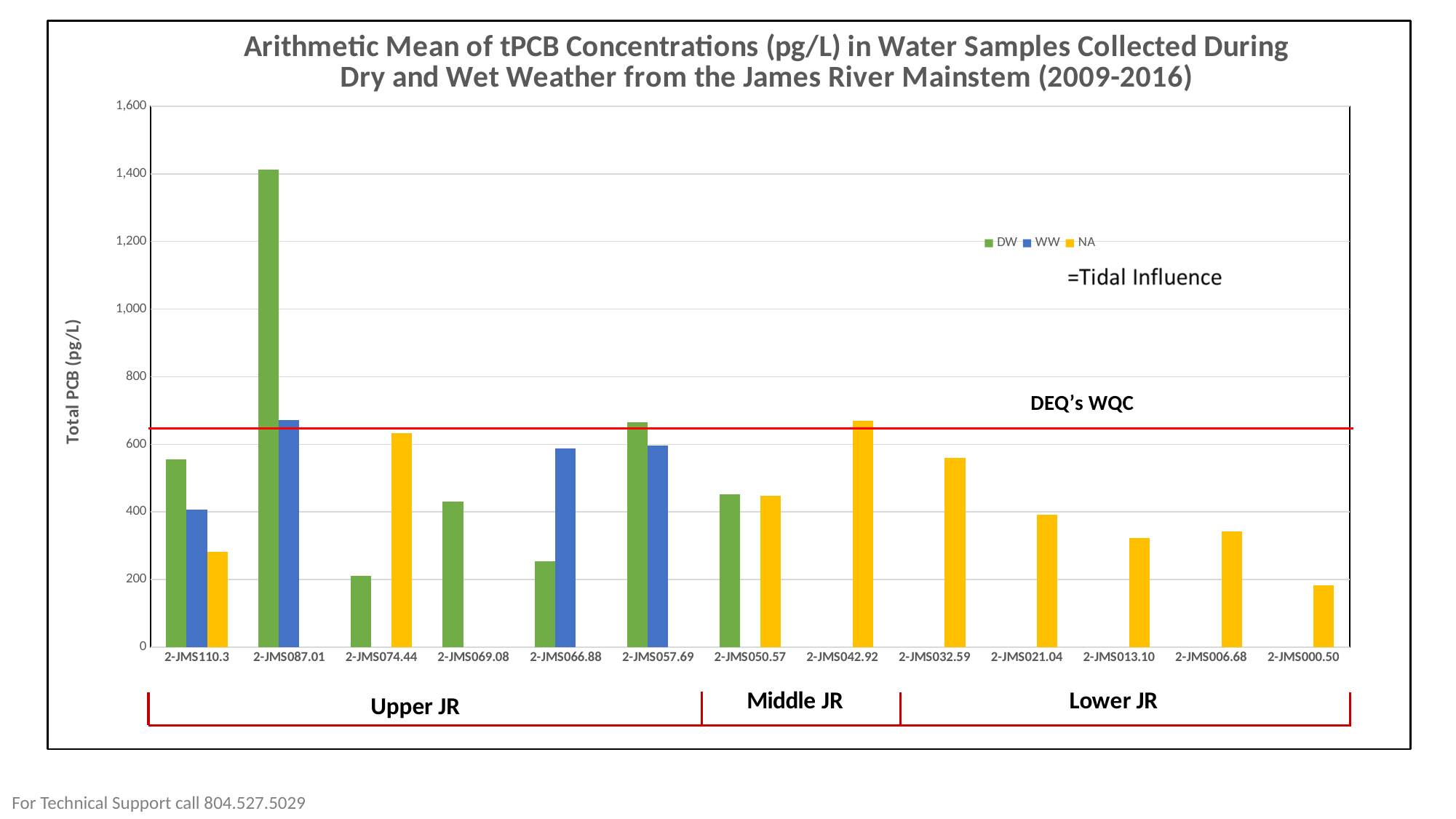
Which station has the lowest NA bar? 2-JMS000.50 What label is given to the red horizontal line on the chart? DEQ's WQC At station 2-JMS110.3, which is larger, the DW bar or the WW bar? DW At station 2-JMS066.88, which is larger, the DW bar or the WW bar? WW Is the DW value for 2-JMS087.01 greater or less than 1,200? greater What kind of chart is shown on the slide? bar chart Is the NA value for 2-JMS021.04 greater or less than 600? less Is the NA value for 2-JMS042.92 greater or less than 600? greater Which station has the highest DW bar? 2-JMS087.01 How many sampling stations are shown along the x axis? 13 How many series does the legend list? 3